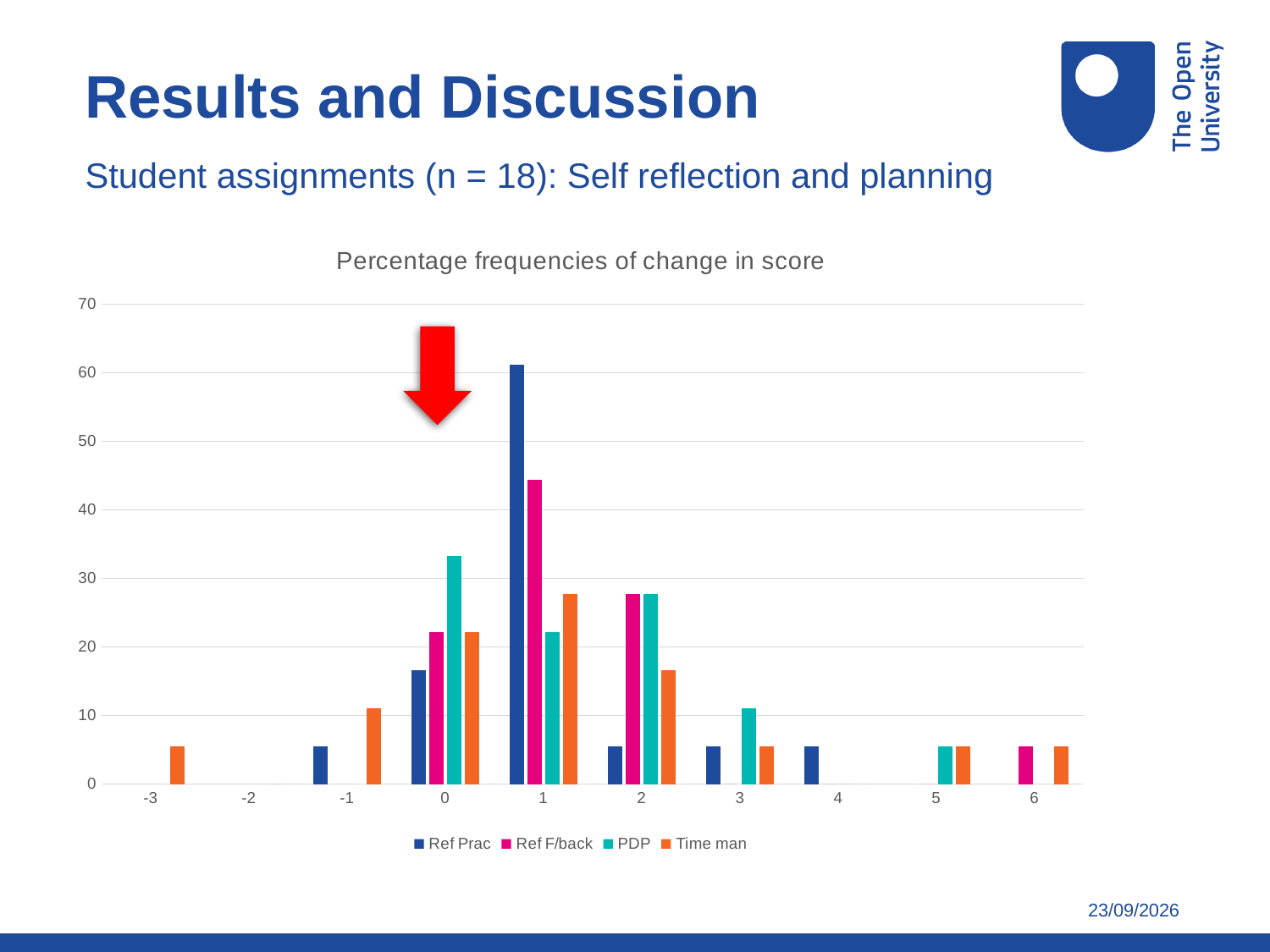
Which series has the highest bar at category 1? Ref Prac Which series has the highest bar at category 0? PDP How many categories are shown on the x axis? 10 What is the title of the chart? Percentage frequencies of change in score Is the value for PDP at category 0 greater or less than 30? greater At category 2, which is larger: Time man or Ref Prac? Time man At category 1, which is larger: Ref Prac or Ref F/back? Ref Prac How many series does the legend list? 4 Is the value for Ref Prac at category 0 greater or less than 20? less Is the value for Ref Prac at category 1 greater or less than 50? greater What kind of chart is shown on the slide? bar chart